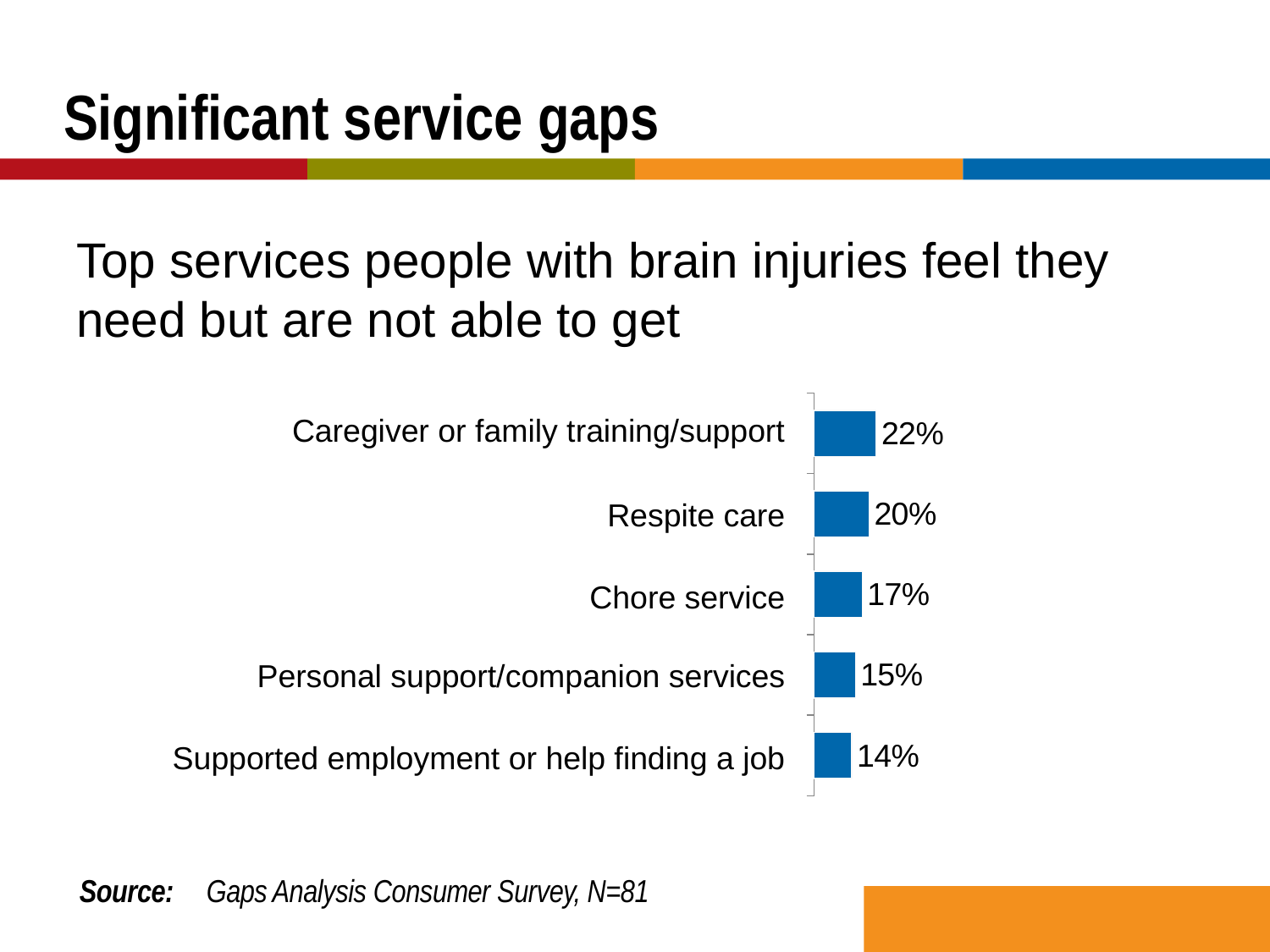
How many services are listed in the chart? 5 Which has a higher value, Respite care or Personal support/companion services? Respite care What is the difference in percentage points between Caregiver or family training/support and Respite care? 2 percentage points What is the value shown for Chore service? 17% What is the value shown for Supported employment or help finding a job? 14% Which service has the highest percentage in the chart? Caregiver or family training/support What is the source cited for the chart data? Gaps Analysis Consumer Survey, N=81 What is the difference in percentage points between Chore service and Supported employment or help finding a job? 3 percentage points What type of chart is shown on the slide? Bar chart What is the value shown for Respite care? 20% What percentage of respondents said they need but cannot get caregiver or family training/support? 22% Which service has the lowest percentage in the chart? Supported employment or help finding a job